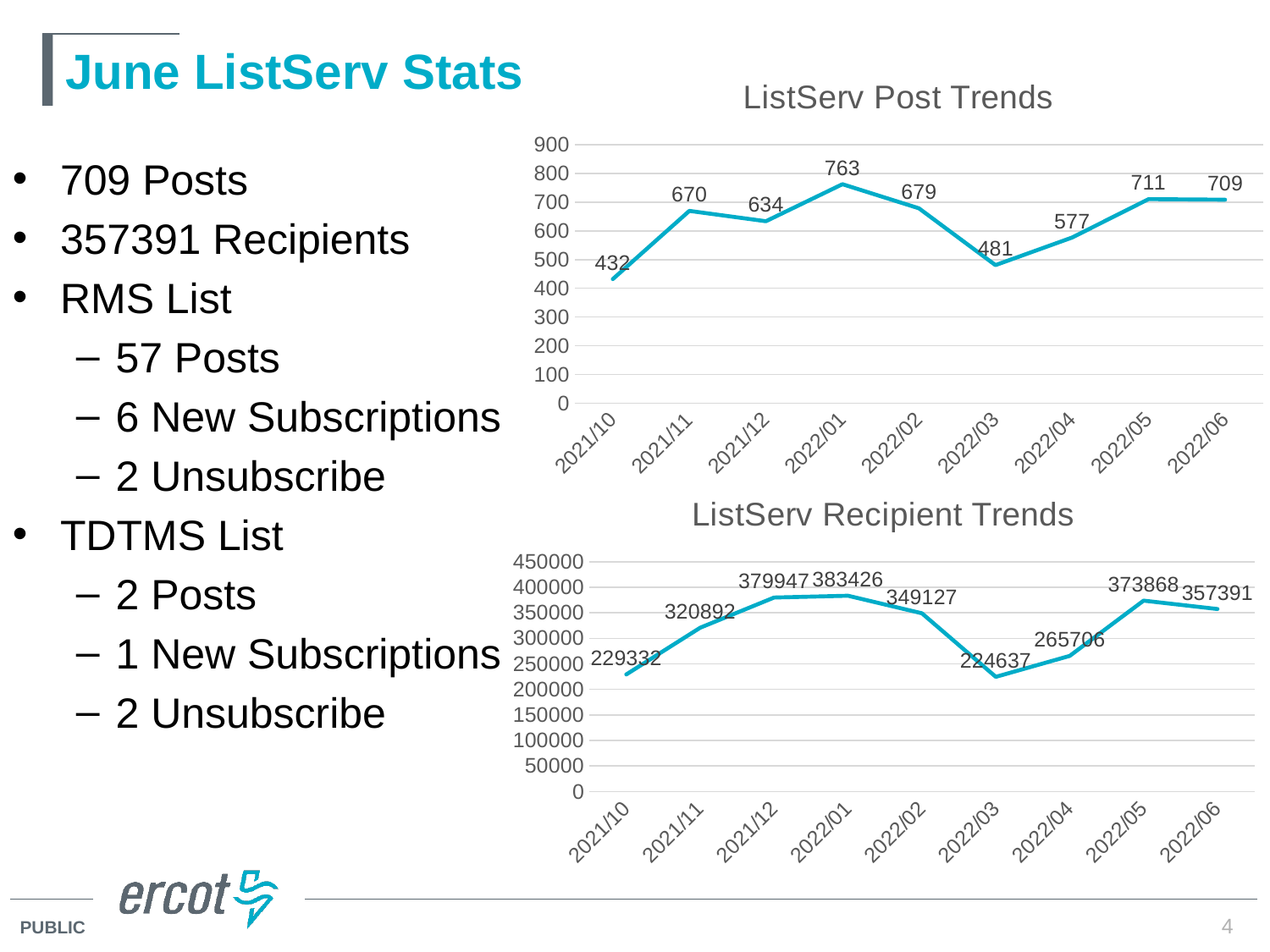
In the ListServ Post Trends chart, which month has the lowest value? 2021/10 In the ListServ Recipient Trends chart, what is the value for 2022/06? 357391 In the ListServ Post Trends chart, what is the value for 2022/01? 763 In the ListServ Post Trends chart, is the value for 2021/11 greater or less than 2021/12? greater In the ListServ Recipient Trends chart, what is the difference between the values for 2022/05 and 2022/04? 108162 What type of chart is the ListServ Post Trends chart? Line chart What is the title of the lower chart on the slide? ListServ Recipient Trends In the ListServ Recipient Trends chart, which month has the lowest value? 2022/03 In the ListServ Recipient Trends chart, do the values rise or fall from 2022/03 to 2022/05? Rise In the ListServ Recipient Trends chart, which month has the highest value? 2022/01 In the ListServ Post Trends chart, how many data points are plotted? 9 In the ListServ Post Trends chart, what is the difference between the values for 2022/05 and 2022/03? 230